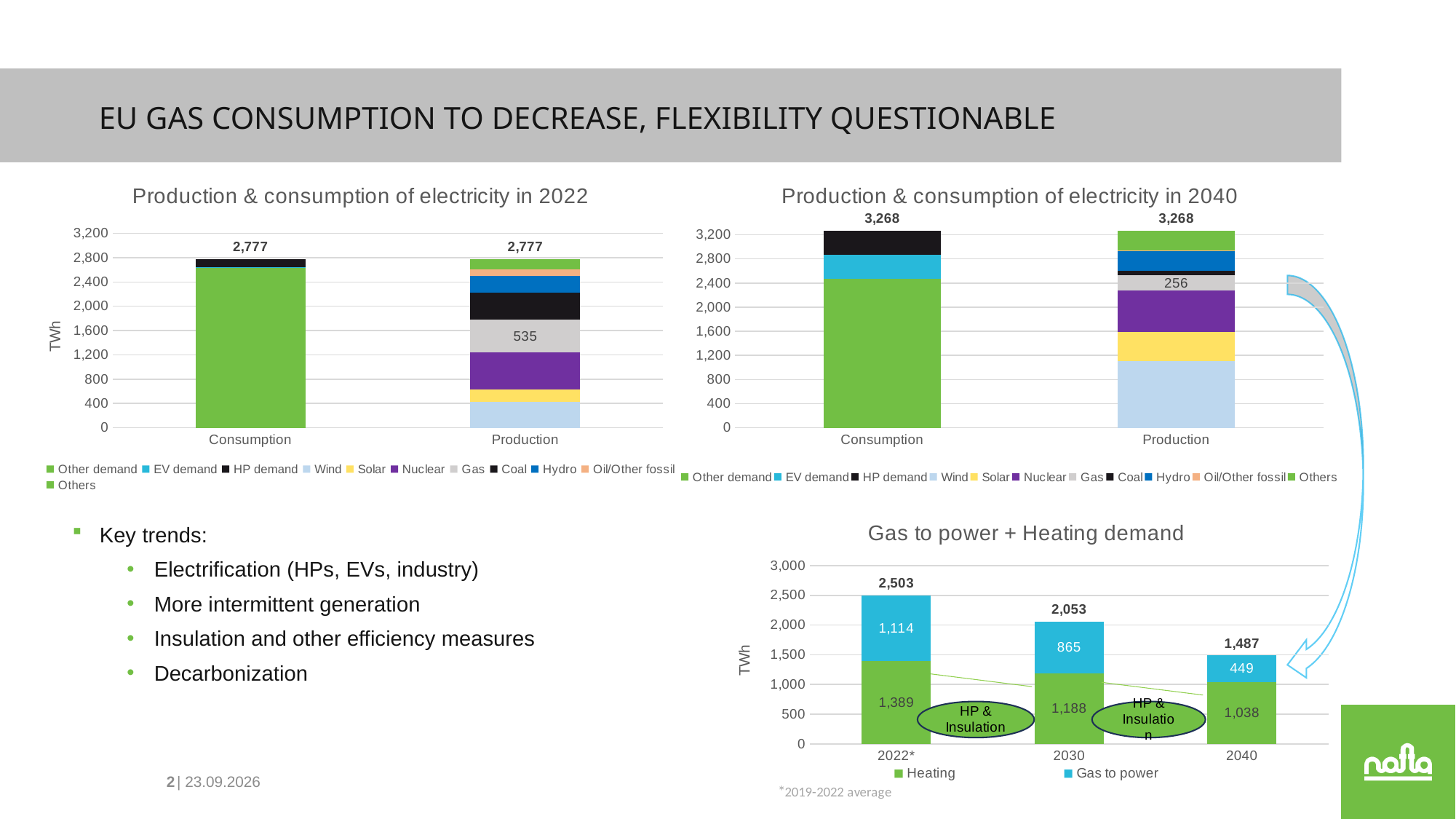
In the 'Gas to power + Heating demand' chart, which year has the lowest total? 2040 What is the difference between the Gas value in the Production bar of the 2022 chart and the Gas value in the Production bar of the 2040 chart? 279 In the 'Gas to power + Heating demand' chart, what is the Heating value for 2030? 1,188 In the 'Production & consumption of electricity in 2022' chart, what is the Gas value in the Production bar? 535 In the 'Gas to power + Heating demand' chart, what is the difference between the Gas to power values for 2022* and 2030? 249 In the 'Production & consumption of electricity in 2040' chart, what is the total of the Consumption bar? 3,268 In the 'Gas to power + Heating demand' chart, what is the Gas to power value for 2040? 449 In the 'Gas to power + Heating demand' chart, what is the total of the stacked bar for 2022*? 2,503 In the 'Gas to power + Heating demand' chart, do the totals rise or fall from 2022* to 2040? fall In the 'Production & consumption of electricity in 2022' chart, how many categories are shown on the x axis? 2 In the 'Gas to power + Heating demand' chart, how many series does the legend list? 2 What kind of chart is 'Gas to power + Heating demand'? stacked bar chart